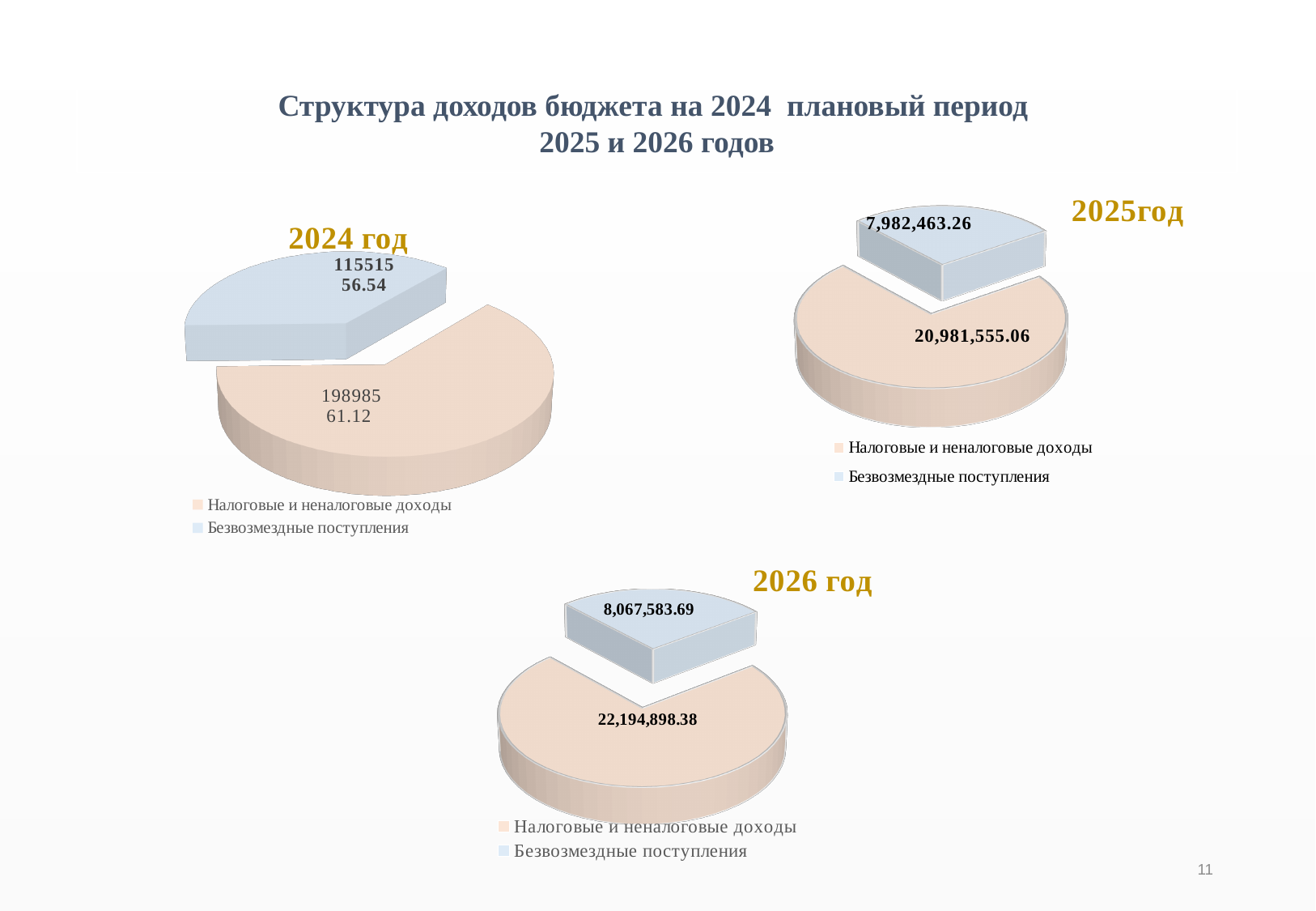
In the 2026 год chart, what is the value for Налоговые и неналоговые доходы? 22,194,898.38 In the 2025 год chart, what is the value for Налоговые и неналоговые доходы? 20,981,555.06 In the 2026 год chart, what is the value for Безвозмездные поступления? 8,067,583.69 In the 2025 год chart, what is the difference between Налоговые и неналоговые доходы and Безвозмездные поступления? 12,999,091.80 In the 2024 год chart, which category has the smallest slice? Безвозмездные поступления In the 2025 год chart, what is the value for Безвозмездные поступления? 7,982,463.26 In the 2026 год chart, which category has the largest slice? Налоговые и неналоговые доходы Which is larger: Безвозмездные поступления in the 2025 год chart or Безвозмездные поступления in the 2026 год chart? 2026 год How many charts are shown on the slide? 3 What kind of chart is the 2024 год chart? Pie chart How many slices does the 2025 год chart have? 2 In the 2026 год chart, what is the difference between Налоговые и неналоговые доходы and Безвозмездные поступления? 14,127,314.69